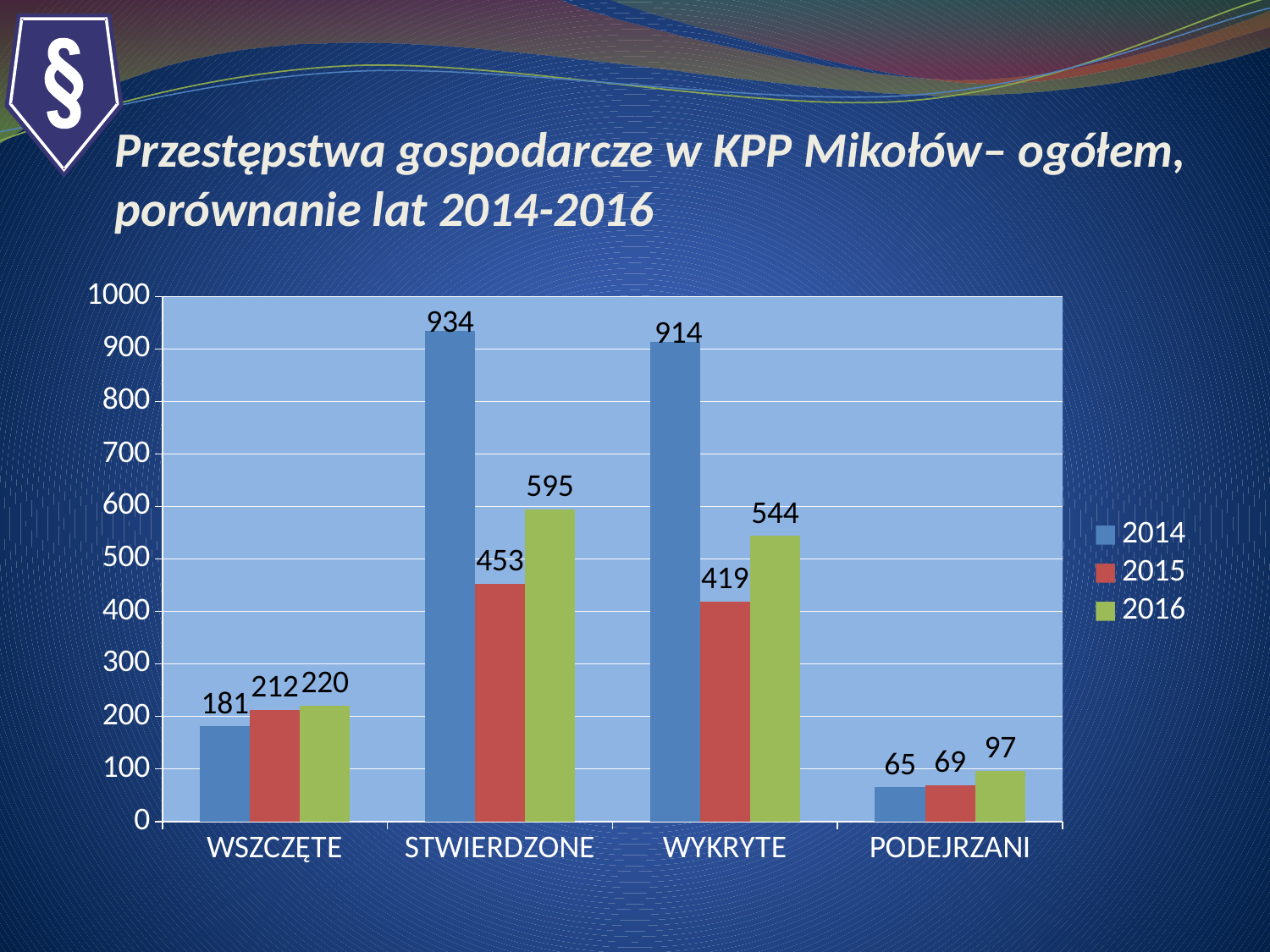
Which category has the lowest value in 2016? PODEJRZANI What is the value for WYKRYTE in 2015? 419 What is the value for STWIERDZONE in 2014? 934 What is the value for PODEJRZANI in 2016? 97 Which is larger for WSZCZĘTE: the 2014 value or the 2016 value? 2016 How many series does the legend list? 3 Which category has the highest value in 2014? STWIERDZONE How many categories are shown on the x axis? 4 What kind of chart is shown on the slide? bar chart Which colour represents the 2015 series in the legend? red What is the difference between the 2014 and 2016 values for STWIERDZONE? 339 What is the difference between the 2016 and 2015 values for WYKRYTE? 125